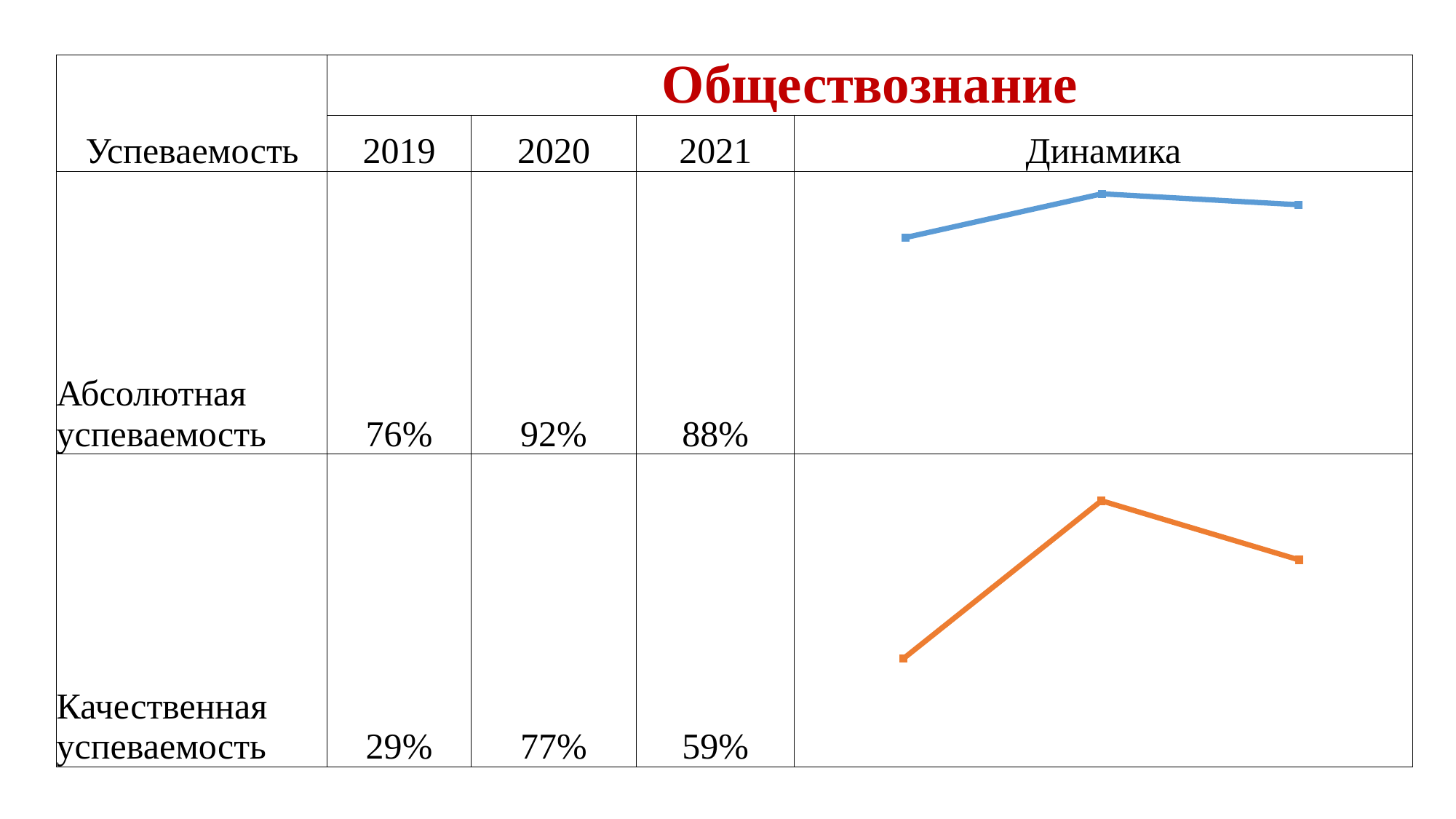
In the orange line chart for Качественная успеваемость, does the line rise or fall from 2019 to 2020? rise How many data points does the blue line chart for Абсолютная успеваемость have? 3 In the orange line chart for Качественная успеваемость, what is the difference between the 2020 and 2021 values? 18% In the blue line chart for Абсолютная успеваемость, what is the value for 2020? 92% What kind of chart is shown in the Динамика column for Абсолютная успеваемость? line chart What colour is the line in the chart for Качественная успеваемость? orange In the blue line chart for Абсолютная успеваемость, does the line rise or fall from 2020 to 2021? fall In the blue line chart for Абсолютная успеваемость, what is the difference between the 2020 and 2019 values? 16% In the orange line chart for Качественная успеваемость, what is the value for 2019? 29% In the orange line chart for Качественная успеваемость, is the value for 2020 larger or smaller than the value for 2021? larger In the orange line chart for Качественная успеваемость, which year has the lowest value? 2019 In the blue line chart for Абсолютная успеваемость, which year has the highest value? 2020